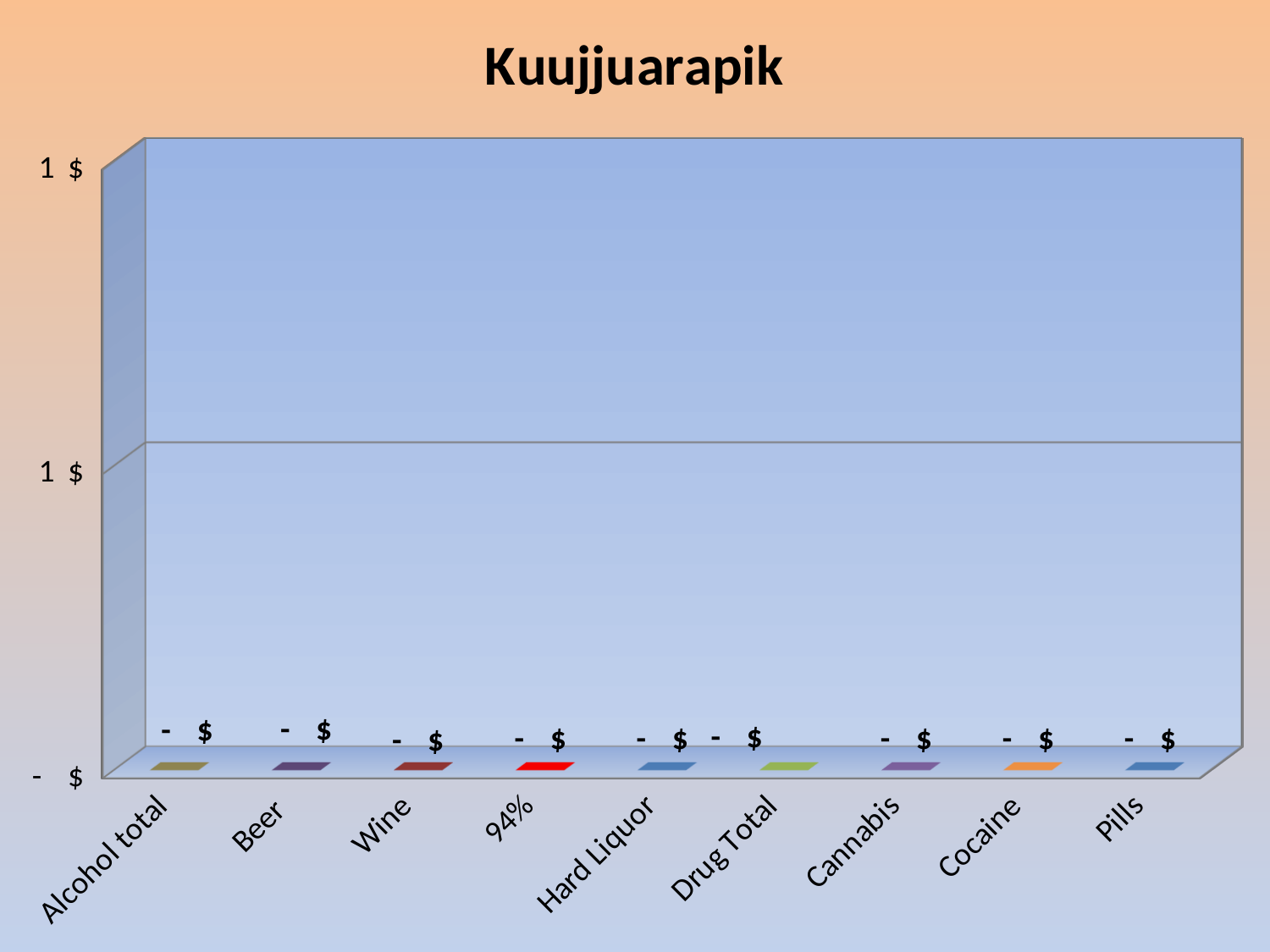
Which category label appears first (leftmost) on the x axis? Alcohol total What kind of chart is shown on the slide? bar chart What is the data label shown for Pills? - $ Is the value for Beer greater or less than 1 $? less Is the value for Cocaine greater or less than 1 $? less What is the data label shown for Alcohol total? - $ What is the data label shown for Cannabis? - $ How many categories are shown on the x axis of the chart? 9 What is the title of the chart? Kuujjuarapik Do the values rise, fall, or stay the same across the categories from left to right? stay the same